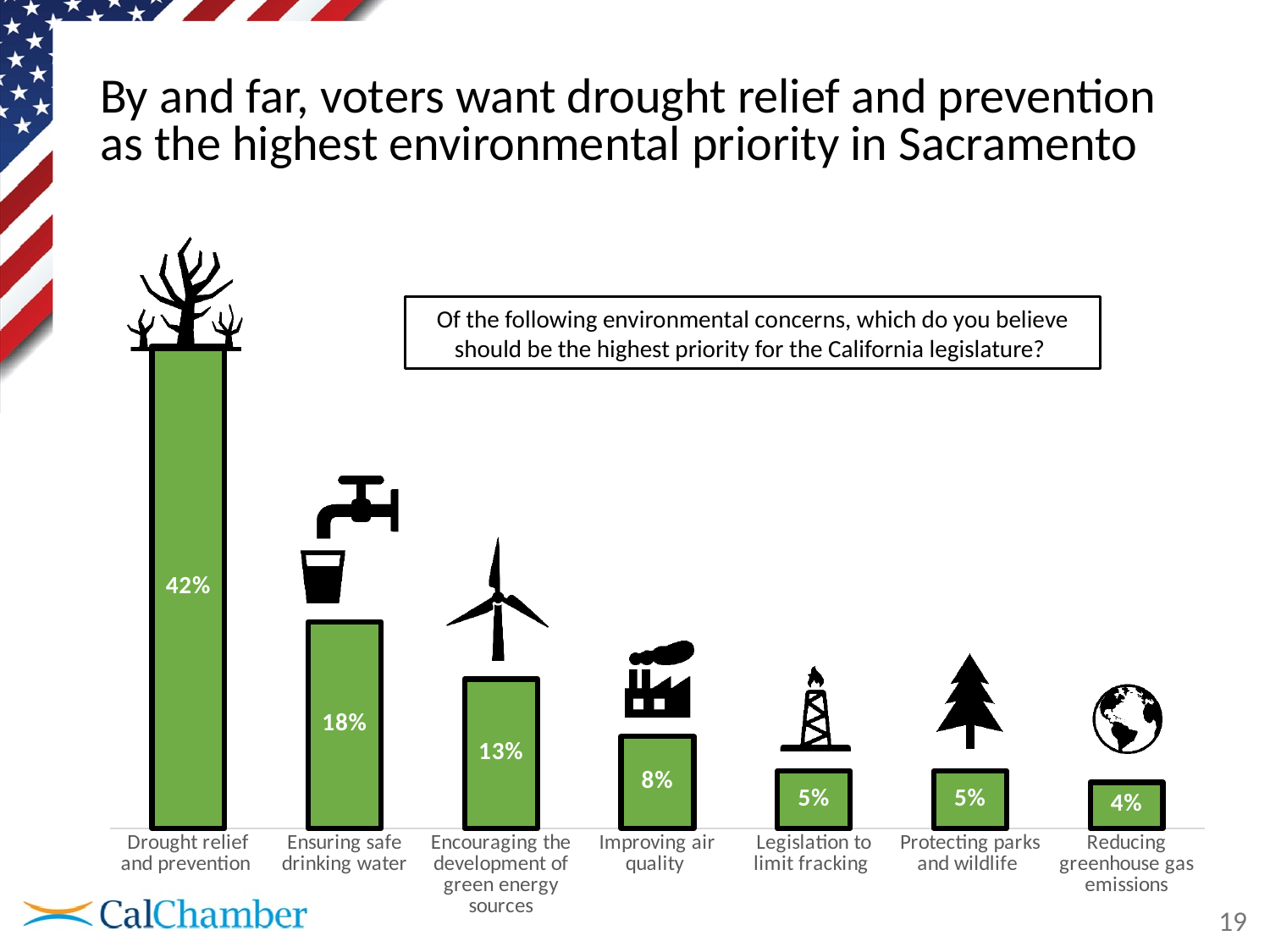
What percentage is shown for reducing greenhouse gas emissions? 4% What is the difference between the values for drought relief and prevention and ensuring safe drinking water? 24% Do the values rise or fall moving from left to right across the chart? Fall What percentage is shown for encouraging the development of green energy sources? 13% What is the value for ensuring safe drinking water? 18% What percentage of voters chose drought relief and prevention as the highest priority? 42% Which environmental concern has the lowest percentage? Reducing greenhouse gas emissions What is the value for improving air quality? 8% Which is larger, the value for improving air quality or the value for legislation to limit fracking? Improving air quality What kind of chart is shown on the slide? Bar chart How many environmental concerns are shown in the chart? 7 Which environmental concern has the highest percentage? Drought relief and prevention